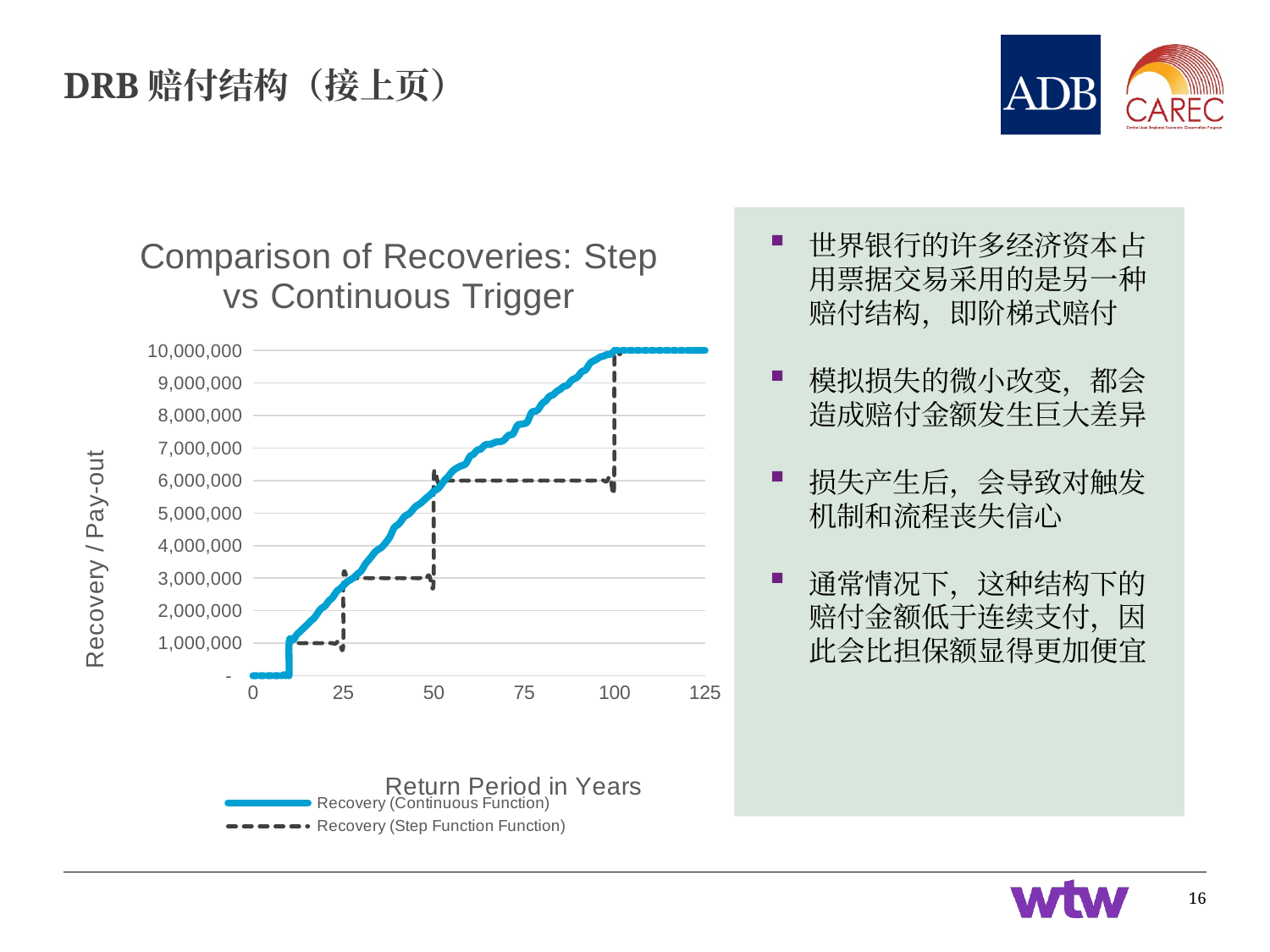
At a return period of 75 years, which series has the higher value: Recovery (Continuous Function) or Recovery (Step Function Function)? Recovery (Continuous Function) What is the value of Recovery (Step Function Function) at a return period of 40 years? 3,000,000 What is the value of Recovery (Step Function Function) at a return period of 110 years? 10,000,000 Does Recovery (Continuous Function) rise or fall as the return period increases from 0 to 100 years? rises Is the value of Recovery (Continuous Function) at a return period of 25 years greater or less than 4,000,000? less What is the label of the x axis of the chart? Return Period in Years What is the value of Recovery (Continuous Function) at a return period of 125 years? 10,000,000 What is the value of Recovery (Step Function Function) at a return period of 75 years? 6,000,000 Is the value of Recovery (Continuous Function) at a return period of 50 years greater or less than 5,000,000? greater How many series does the chart legend list? 2 What is the title of the chart? Comparison of Recoveries: Step vs Continuous Trigger What kind of chart is shown on the slide? line chart